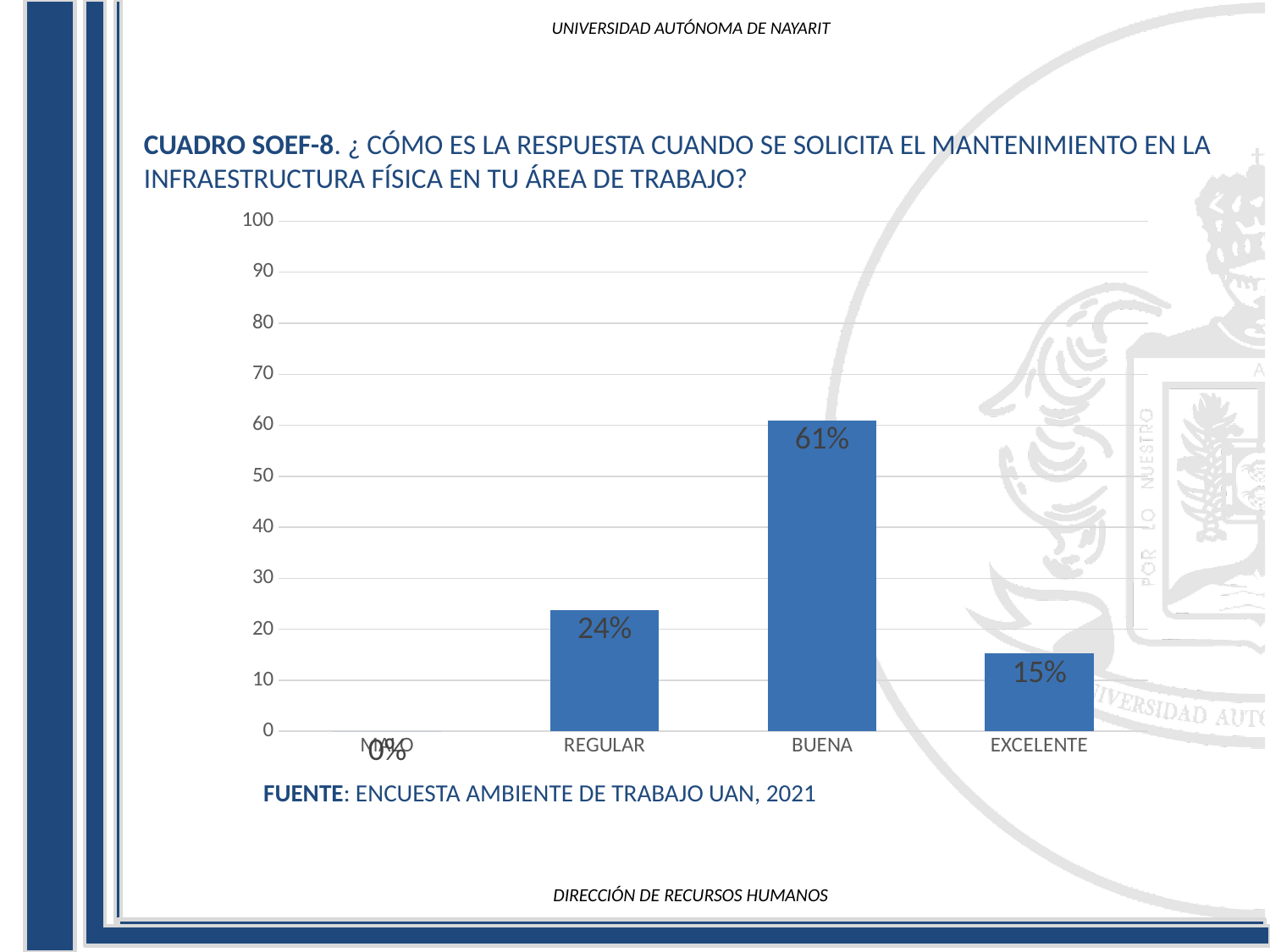
Which category has the highest value? BUENA What is the value for EXCELENTE? 15% What is the value for BUENA? 61% Is the value for BUENA greater or less than 50? greater What is the value for REGULAR? 24% How many categories are shown on the x axis? 4 What is the difference between the values for REGULAR and EXCELENTE? 9% What kind of chart is shown on the slide? bar chart Which is larger, the value for REGULAR or the value for EXCELENTE? REGULAR Is the value for EXCELENTE greater or less than 20? less What is the difference between the values for BUENA and REGULAR? 37% What source is cited below the chart? ENCUESTA AMBIENTE DE TRABAJO UAN, 2021